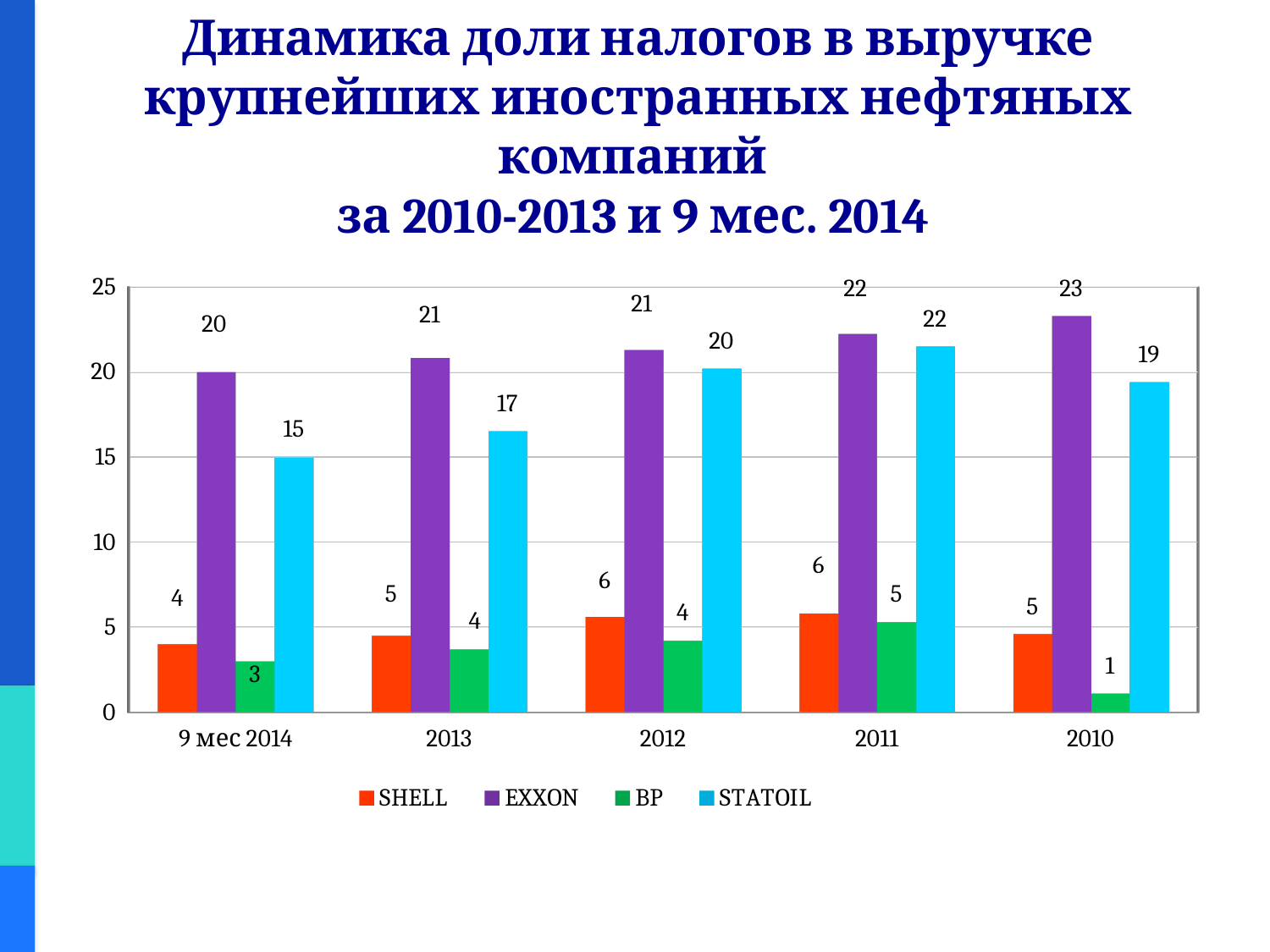
How many periods are shown on the x axis? 5 How many series does the legend list? 4 Do the EXXON values rise or fall moving left to right along the x axis? rise What is the difference between the EXXON and STATOIL values in 9 мес 2014? 5 What kind of chart is shown on the slide? bar chart What is the value for STATOIL in 9 мес 2014? 15 What is the value for BP in 2010? 1 Which company has the highest value in 2013? EXXON In which period does BP have its lowest value? 2010 Is the STATOIL value larger in 2012 or in 2013? 2012 What is the value for EXXON in 2010? 23 What colour represents EXXON in the legend? purple